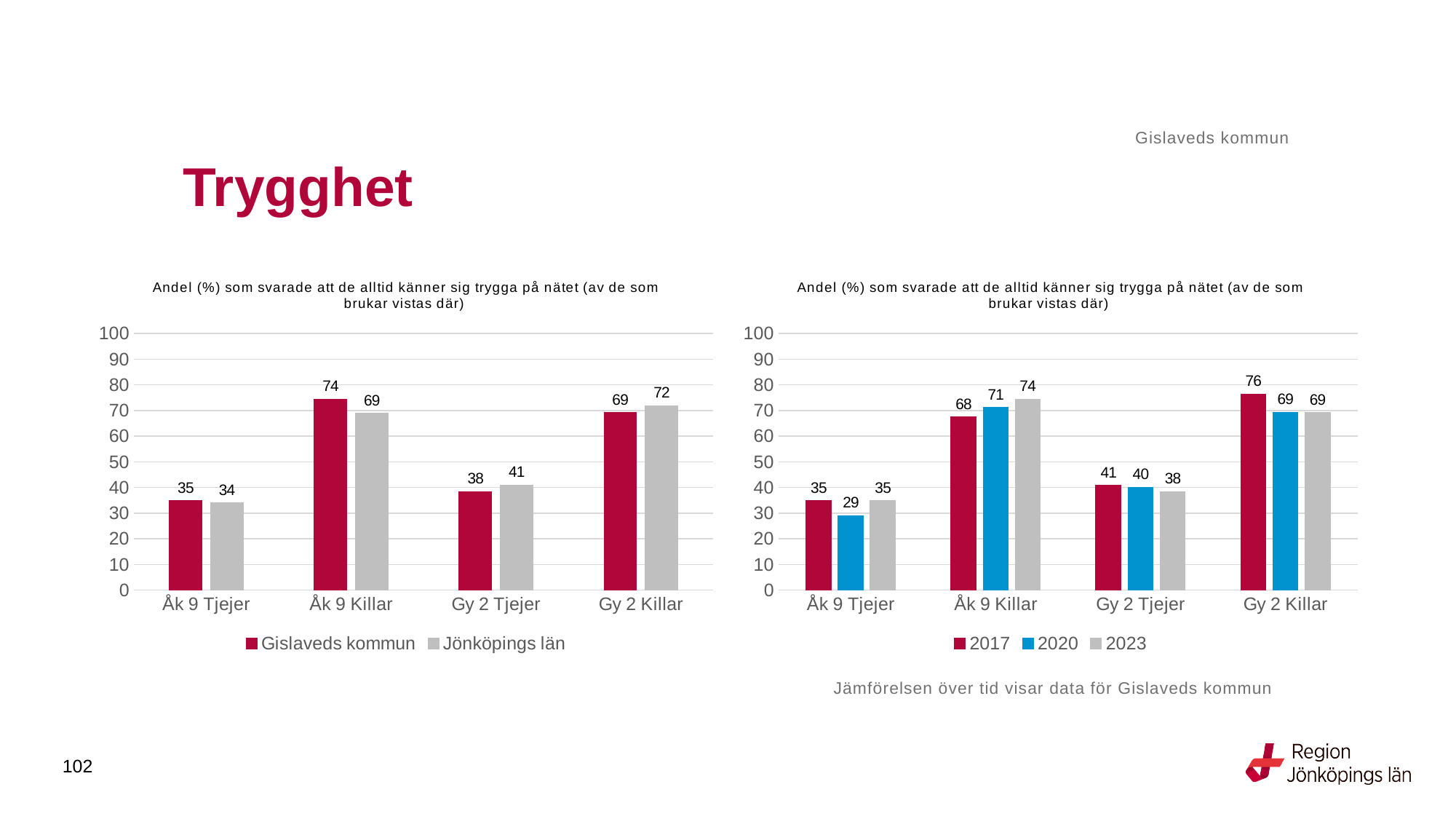
In the left chart, what is the value for Gislaveds kommun for Åk 9 Killar? 74 In the left chart, what is the difference between Gislaveds kommun and Jönköpings län for Åk 9 Killar? 5 In the left chart, how many series does the legend list? 2 In the right chart, which category has the highest value for 2023? Åk 9 Killar What kind of chart is the right chart? bar chart In the right chart, what is the value for 2017 for Gy 2 Killar? 76 In the left chart, which category has the lowest value for Jönköpings län? Åk 9 Tjejer In the right chart, what is the value for 2020 for Åk 9 Tjejer? 29 In the right chart, do the values for Åk 9 Killar rise or fall from 2017 to 2023? rise In the left chart, which is larger for Gy 2 Killar: Gislaveds kommun or Jönköpings län? Jönköpings län In the left chart, what is the value for Jönköpings län for Gy 2 Tjejer? 41 In the right chart, what is the difference between the 2017 and 2023 values for Gy 2 Killar? 7